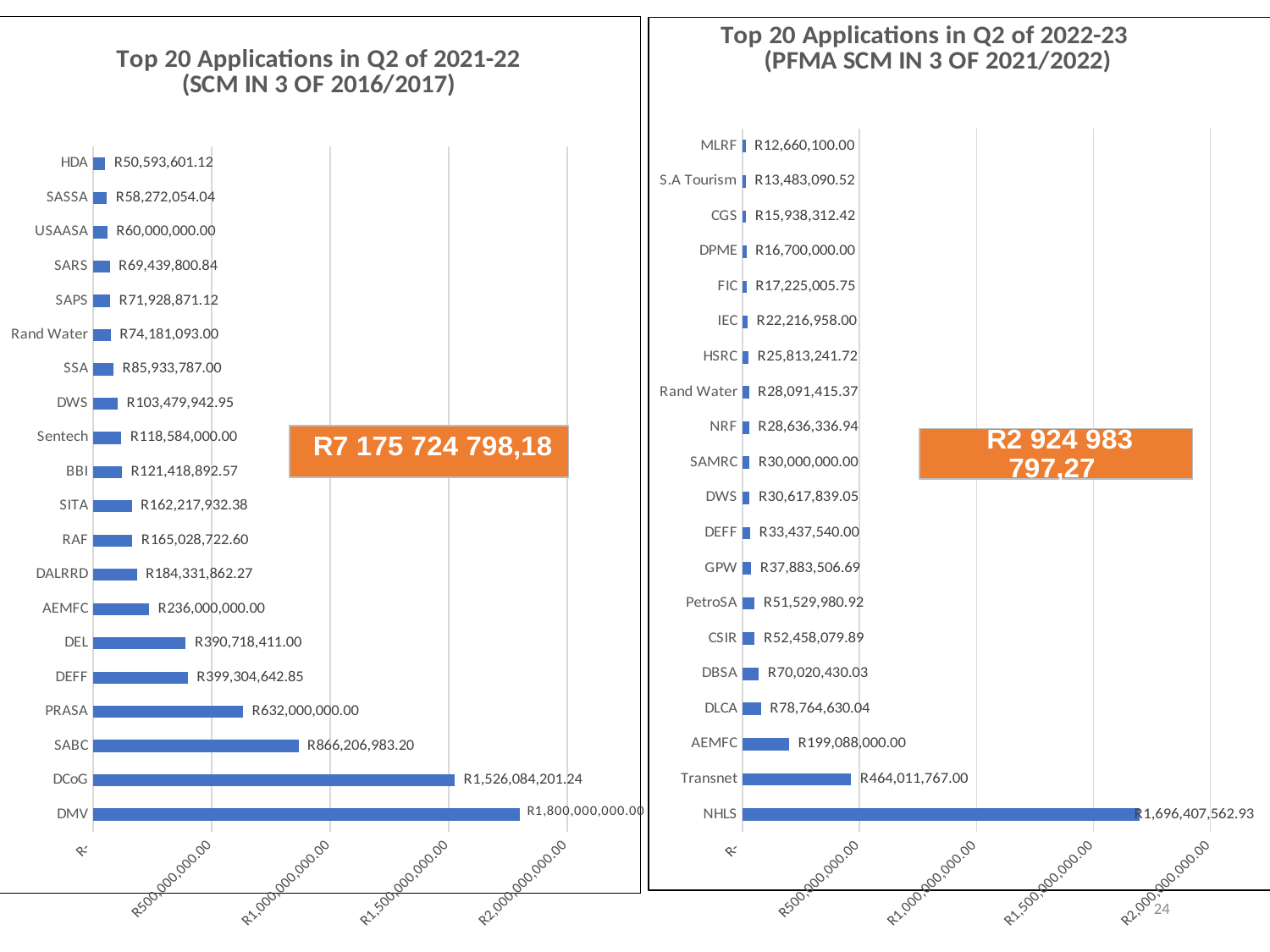
In the left chart (Top 20 Applications in Q2 of 2021-22), which is larger: the value for PRASA or the value for DEFF? PRASA In the right chart (Top 20 Applications in Q2 of 2022-23), what is the difference between the values for NHLS and Transnet? R1,232,395,795.93 What total is shown in the orange box on the left chart (Top 20 Applications in Q2 of 2021-22)? R7 175 724 798,18 In the right chart (Top 20 Applications in Q2 of 2022-23), what is the value for Rand Water? R28,091,415.37 How many entities are plotted in the left chart (Top 20 Applications in Q2 of 2021-22)? 20 In the left chart (Top 20 Applications in Q2 of 2021-22), what is the difference between the values for DMV and DCoG? R273,915,798.76 In the left chart (Top 20 Applications in Q2 of 2021-22), what is the value for SABC? R866,206,983.20 In the right chart (Top 20 Applications in Q2 of 2022-23), which entity has the lowest value? MLRF What type of chart is the right chart (Top 20 Applications in Q2 of 2022-23)? Bar chart In the right chart (Top 20 Applications in Q2 of 2022-23), is the value for NHLS greater or less than R1,500,000,000.00? greater In the left chart (Top 20 Applications in Q2 of 2021-22), which entity has the highest value? DMV In the right chart (Top 20 Applications in Q2 of 2022-23), what is the value for Transnet? R464,011,767.00